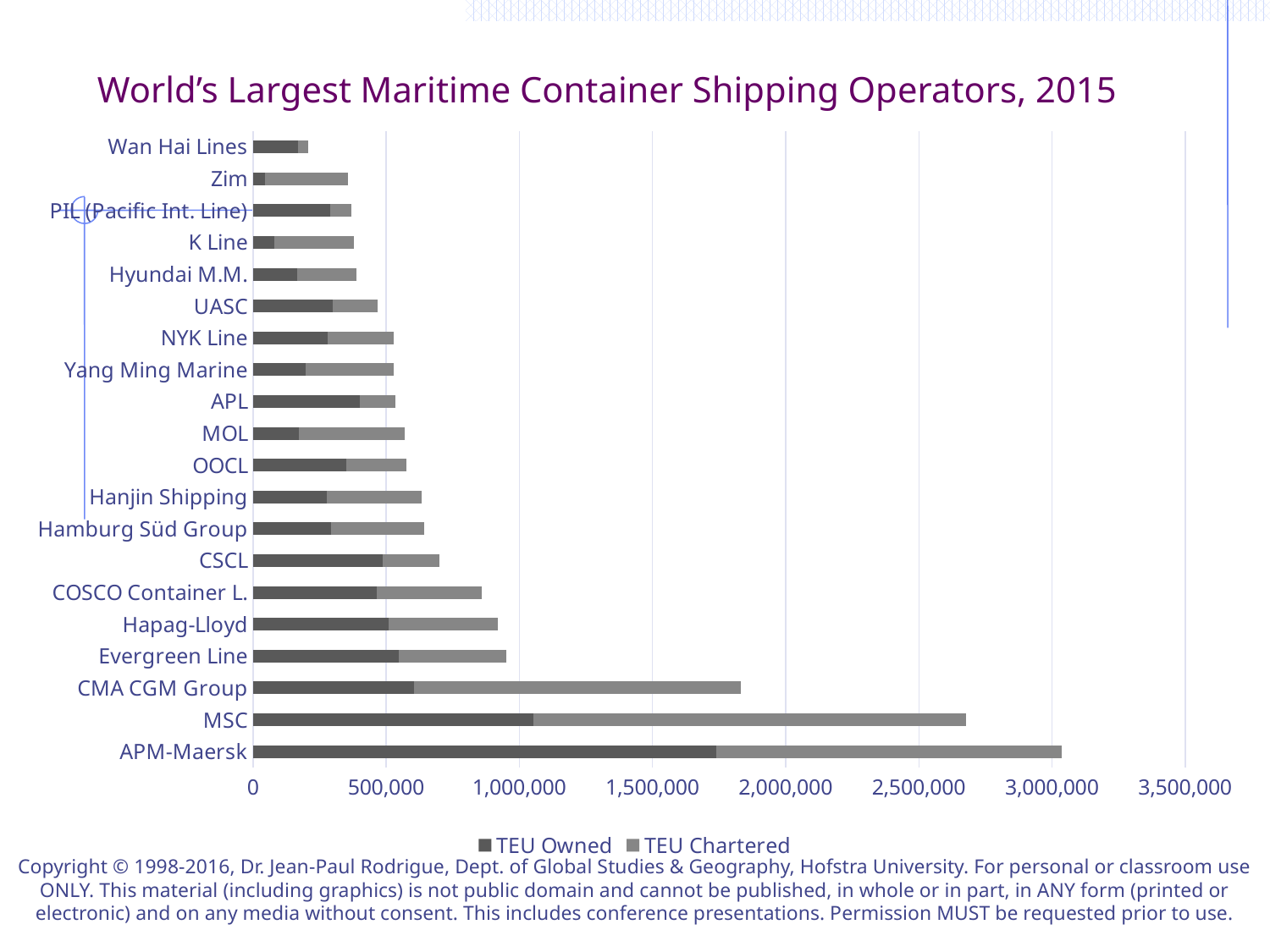
What is the title of the chart? World's Largest Maritime Container Shipping Operators, 2015 What are the two series named in the legend? TEU Owned and TEU Chartered How many series does the legend list? 2 Which operator has the smallest total TEU capacity? Wan Hai Lines Is the total TEU for MSC greater or less than 2,500,000? greater How many shipping operators are listed on the chart? 20 What kind of chart is shown on the slide? Stacked bar chart Is the total TEU for Evergreen Line greater or less than 1,000,000? less Is the total TEU for CMA CGM Group greater or less than 2,000,000? less Which operator has more TEU Owned, APM-Maersk or MSC? APM-Maersk Which operator has the largest total TEU capacity? APM-Maersk Which has a larger total TEU capacity, COSCO Container L. or CSCL? COSCO Container L.